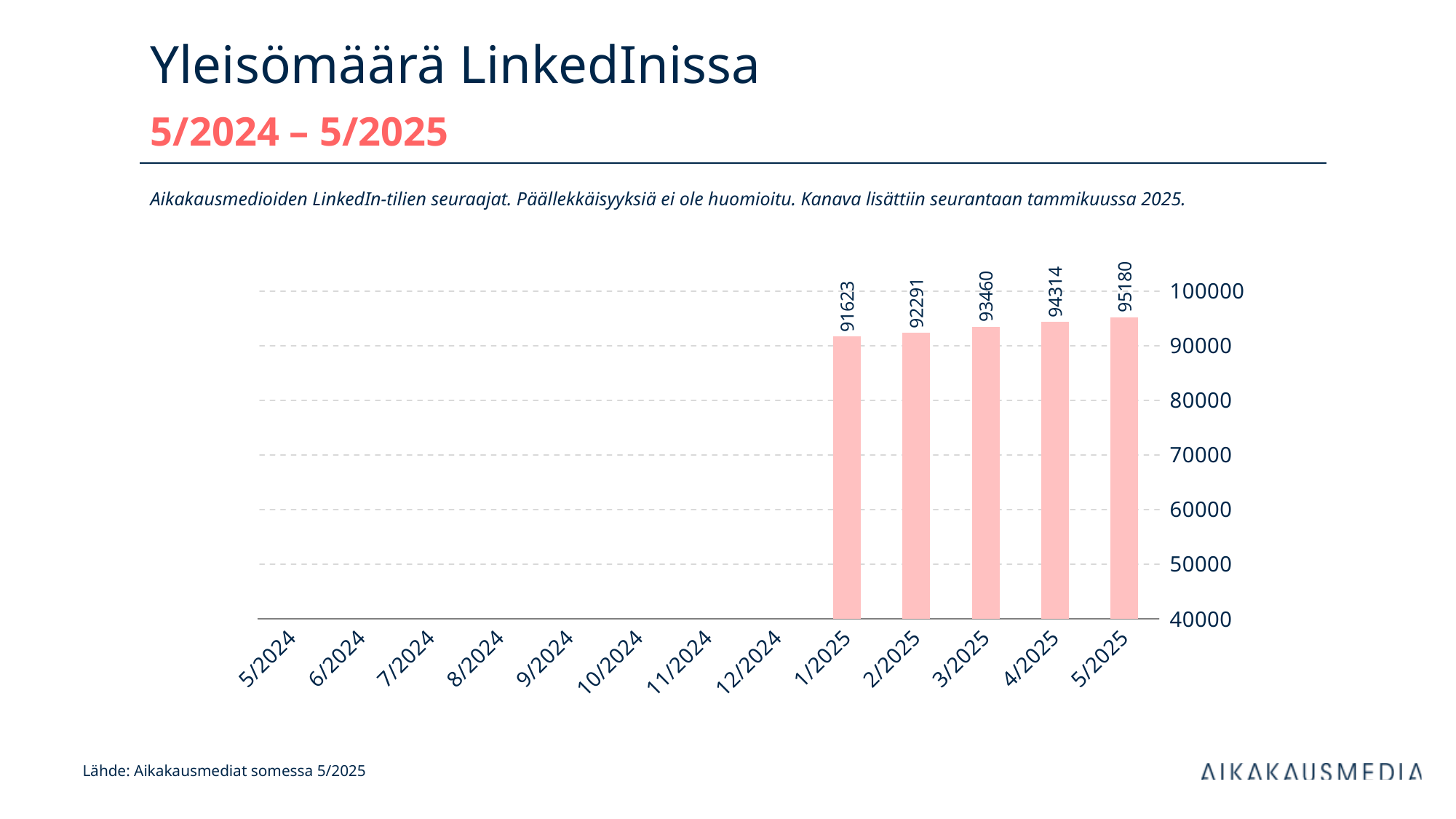
What is the value for 1/2025? 91623 What is the difference between the values for 5/2025 and 1/2025? 3557 What kind of chart is shown on the slide? bar chart Among the months with bars, which has the lowest value? 1/2025 What is the difference between the values for 4/2025 and 2/2025? 2023 Do the values rise or fall from 1/2025 to 5/2025? rise What is the value for 5/2025? 95180 Is the value for 1/2025 greater or less than 90000? greater Which is larger, the value for 2/2025 or the value for 4/2025? 4/2025 Which month has the highest value? 5/2025 How many months have a bar plotted in the chart? 5 What is the value for 3/2025? 93460